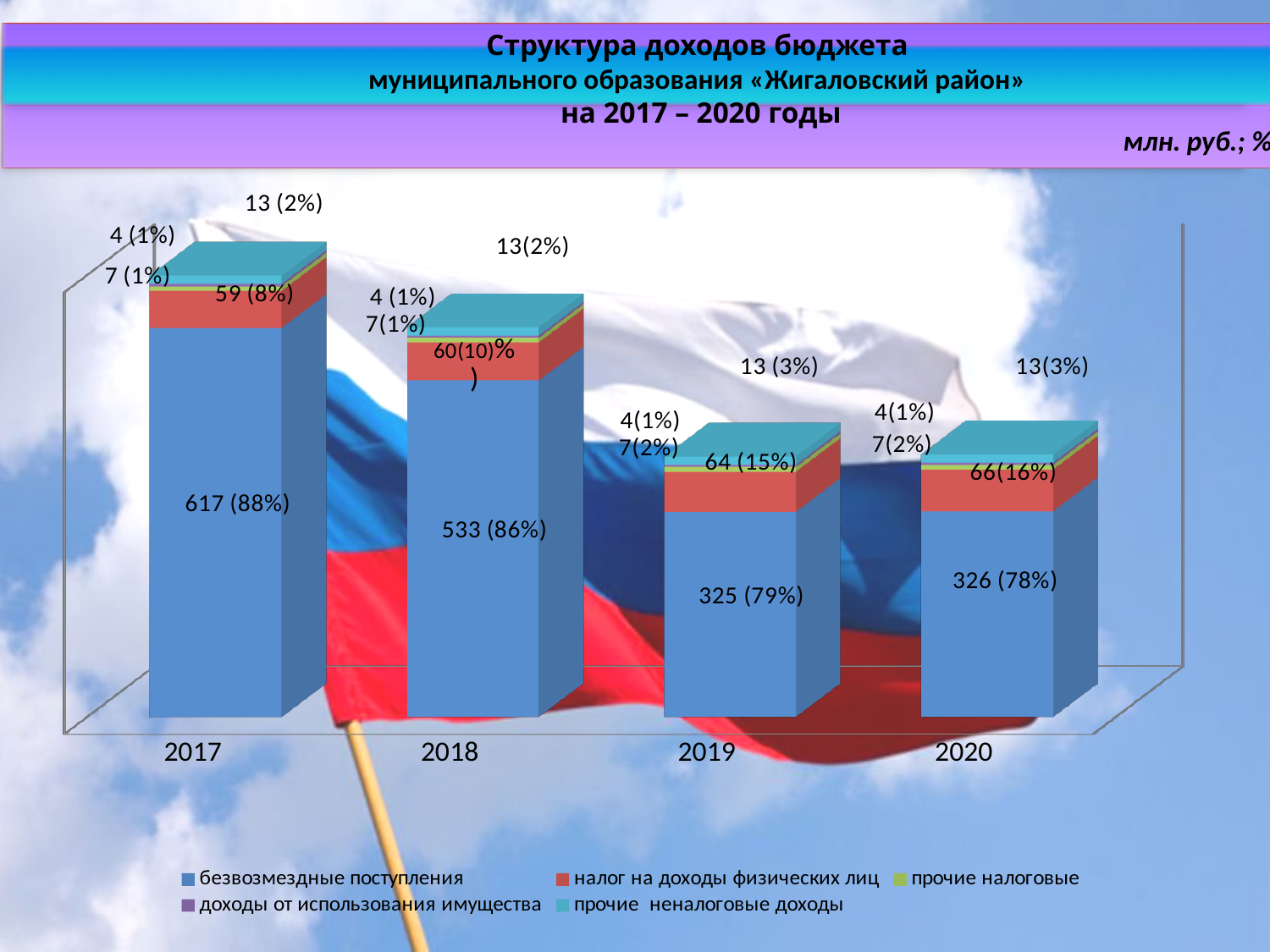
In which year is налог на доходы физических лиц the lowest? 2017 What share of the 2020 budget revenue is безвозмездные поступления? 78% What kind of chart is shown on the slide? stacked bar chart What is the value for безвозмездные поступления in 2017? 617 (88%) How many series does the legend list? 5 Which year has the larger value for налог на доходы физических лиц, 2019 or 2020? 2020 How many years are shown on the x axis? 4 What is the difference between безвозмездные поступления in 2017 and 2018? 84 What is the total of the stacked bar for 2017? 700 In which year is безвозмездные поступления the highest? 2017 What is the value for налог на доходы физических лиц in 2020? 66 (16%) Does безвозмездные поступления rise or fall from 2017 to 2019? fall